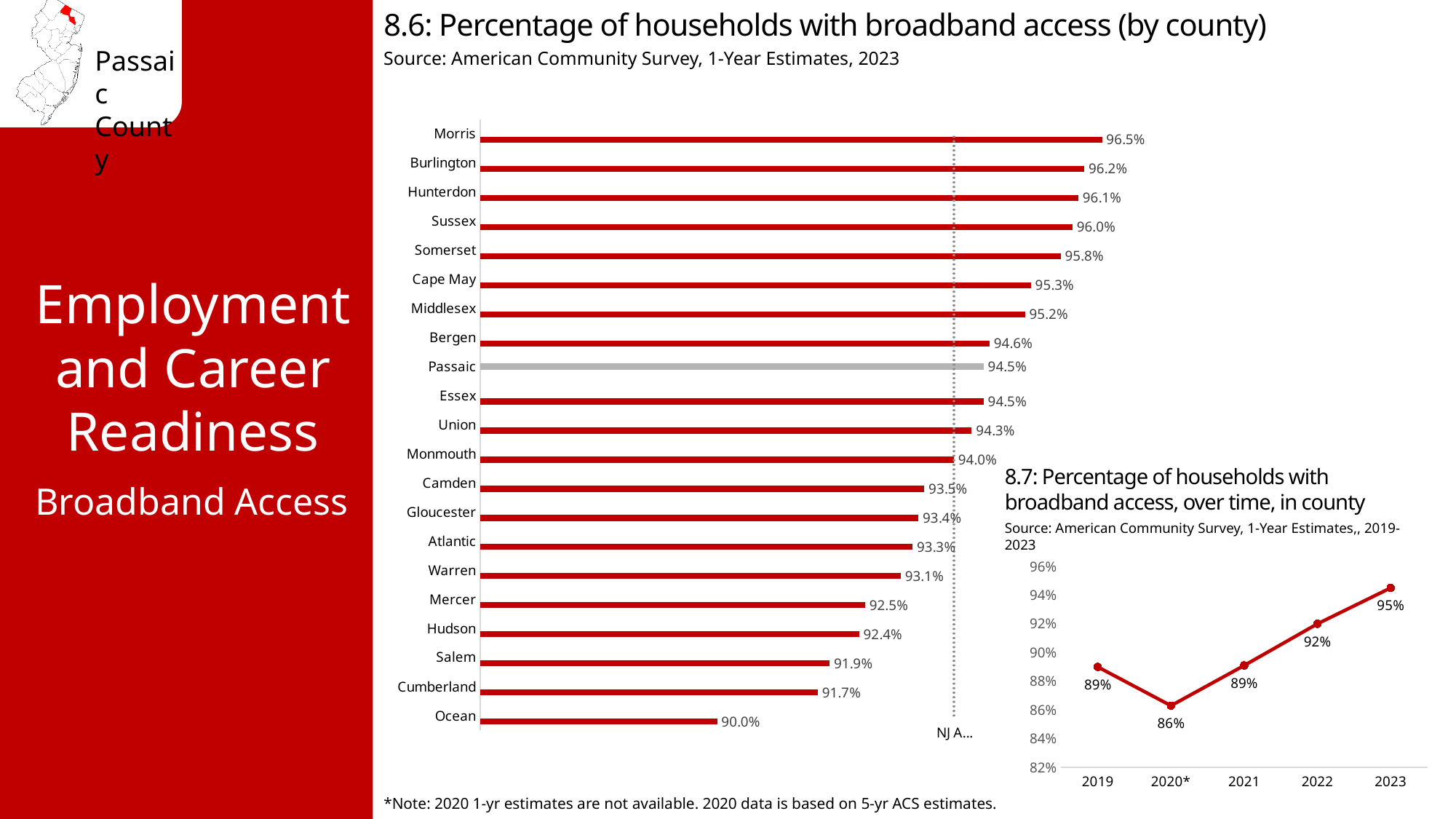
What kind of chart is '8.6: Percentage of households with broadband access (by county)'? Bar chart In the chart '8.6: Percentage of households with broadband access (by county)', what is the value for Passaic? 94.5% In the chart '8.7: Percentage of households with broadband access, over time, in county', what is the value for 2020*? 86% What kind of chart is '8.7: Percentage of households with broadband access, over time, in county'? Line chart In the chart '8.6: Percentage of households with broadband access (by county)', what is the value for Hudson? 92.4% In the chart '8.6: Percentage of households with broadband access (by county)', which county has the highest percentage? Morris In the chart '8.6: Percentage of households with broadband access (by county)', which is larger, Bergen or Camden? Bergen In the chart '8.6: Percentage of households with broadband access (by county)', how many counties are shown? 21 In the chart '8.7: Percentage of households with broadband access, over time, in county', do values rise or fall from 2021 to 2023? Rise In the chart '8.6: Percentage of households with broadband access (by county)', which county has the lowest percentage? Ocean In the chart '8.7: Percentage of households with broadband access, over time, in county', what is the value for 2023? 95% In the chart '8.6: Percentage of households with broadband access (by county)', what is the difference between Morris and Ocean? 6.5%